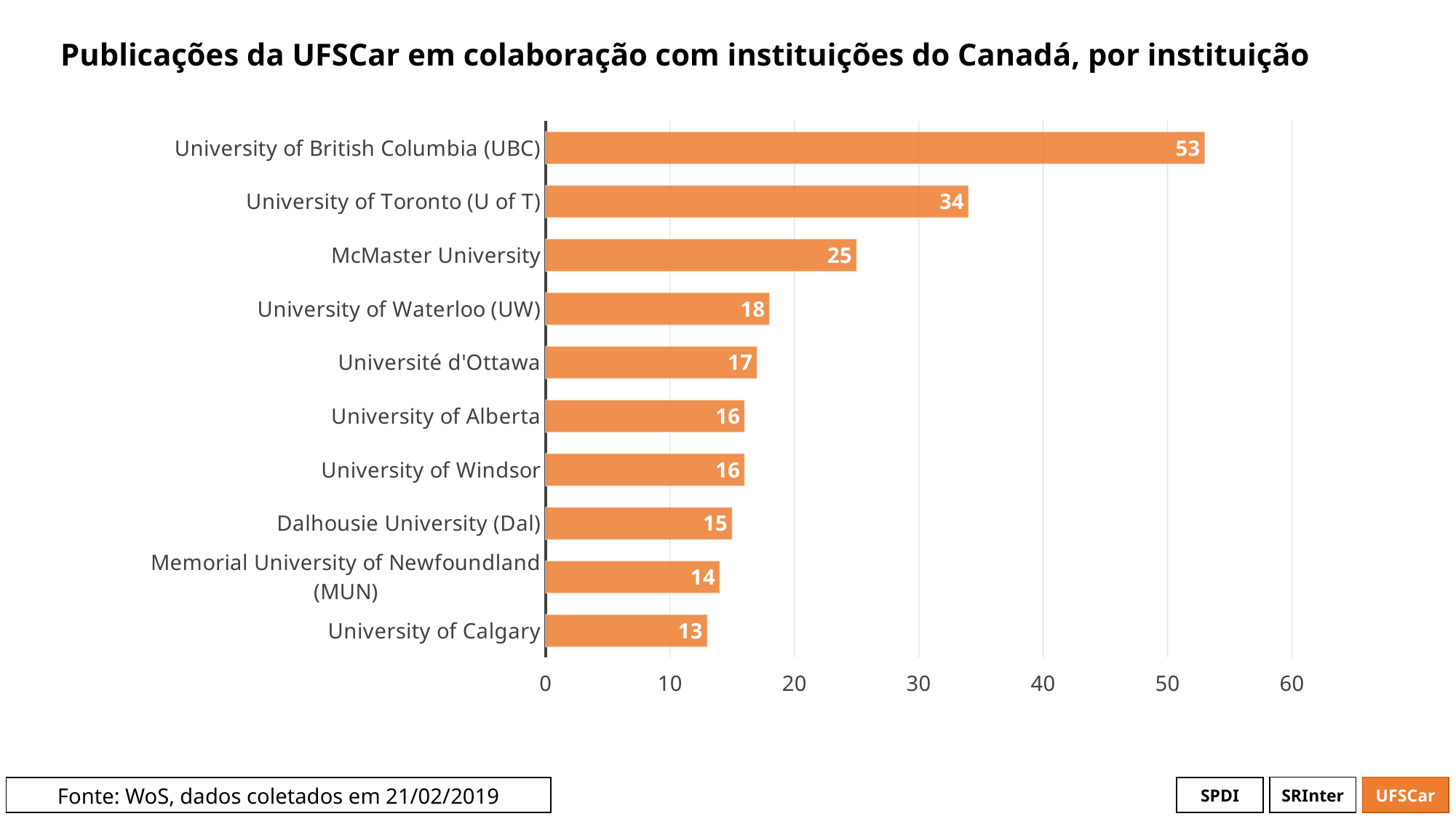
What is the difference between the values for Université d'Ottawa and University of Calgary? 4 Which institution has the lowest value on the chart? University of Calgary Which institution has the highest number of publications in collaboration with UFSCar? University of British Columbia (UBC) Which has a larger value, University of Waterloo (UW) or Dalhousie University (Dal)? University of Waterloo (UW) How many institutions are shown on the chart? 10 What is the difference between the values for University of British Columbia (UBC) and University of Toronto (U of T)? 19 What is the source of the data cited on the slide? WoS, dados coletados em 21/02/2019 How many publications does the chart show for University of British Columbia (UBC)? 53 What is the value shown for McMaster University? 25 What kind of chart is shown on the slide? bar chart What is the value shown for Memorial University of Newfoundland (MUN)? 14 Is the value for University of Toronto (U of T) greater or less than 30? greater